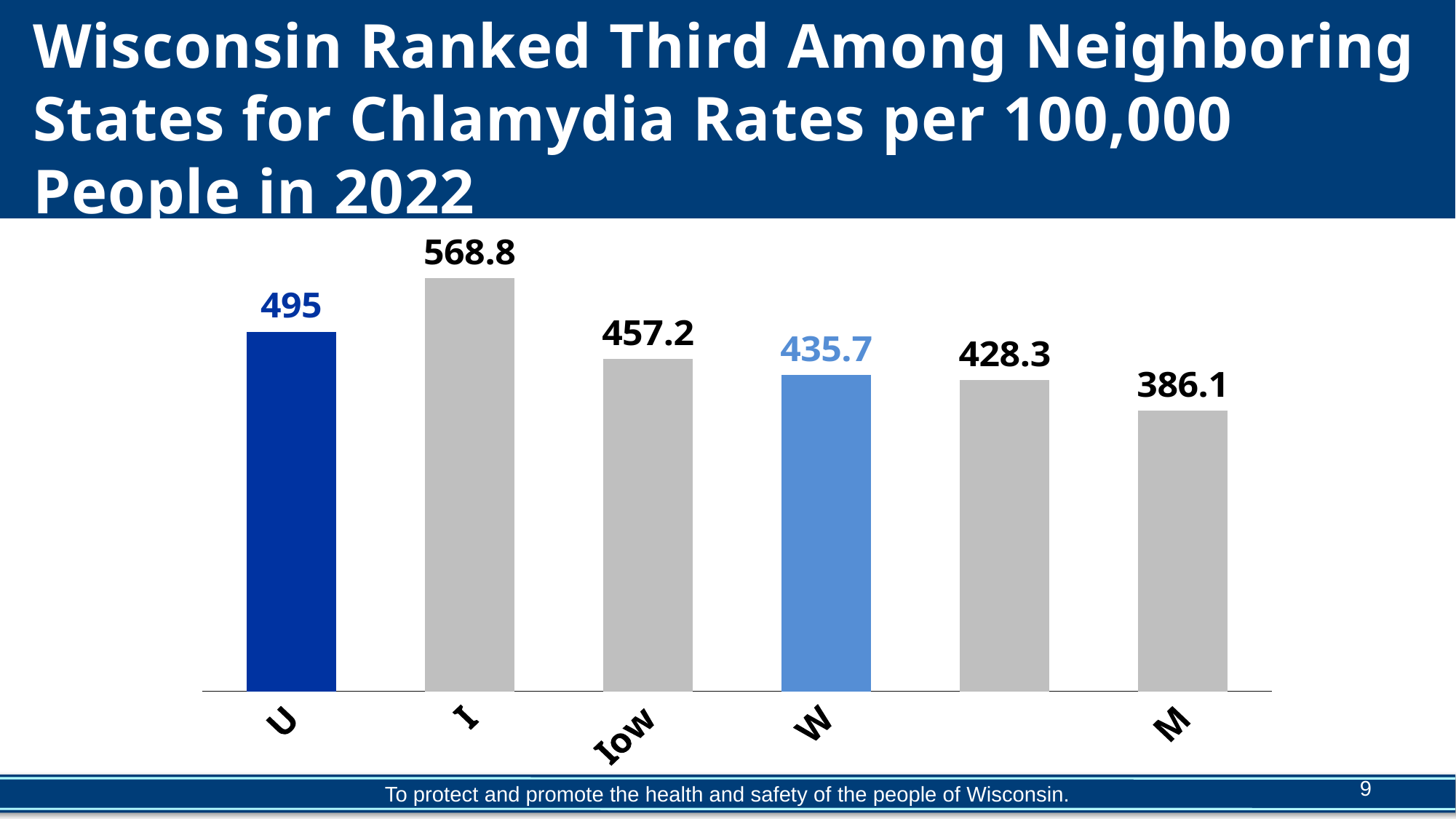
What is the value of the third bar from the left in the chart? 457.2 Which is larger: the value of the dark blue bar or the value of the light blue bar? the dark blue bar (495) What type of chart is shown on the slide? bar chart What is the value of the first (leftmost) bar in the chart? 495 What is the value of the fifth bar from the left in the chart? 428.3 What is the value shown on the tallest bar in the chart? 568.8 How many bars are plotted in the chart? 6 What is the difference between the light blue bar (435.7) and the rightmost bar (386.1)? 49.6 What is the difference between the tallest bar (568.8) and the dark blue bar (495)? 73.8 What is the value shown on the shortest bar in the chart? 386.1 What is the value of the light blue bar in the chart? 435.7 Which bar in the chart is colored dark blue? the first (leftmost) bar, with value 495